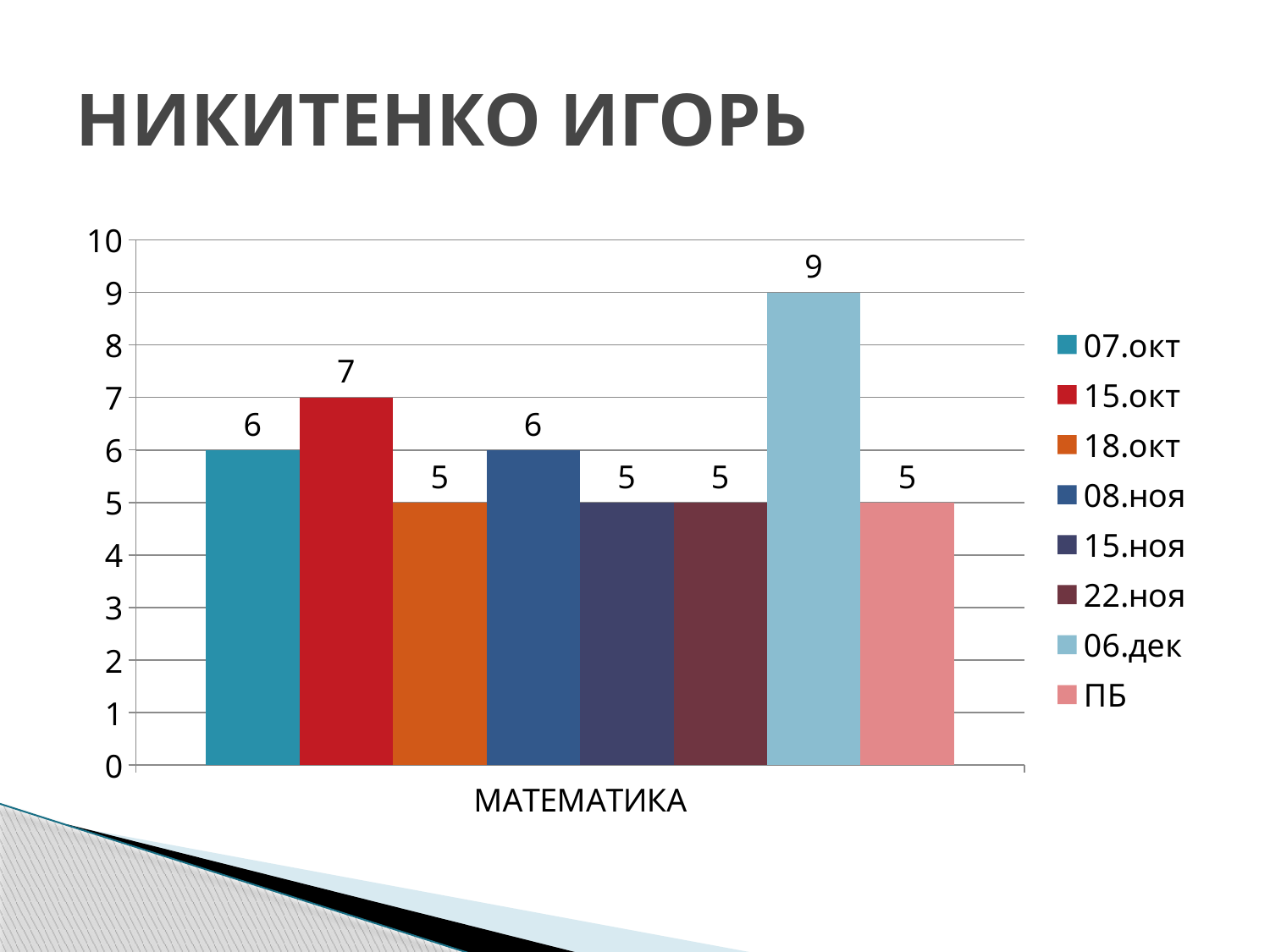
Is the value for 06.дек greater or less than 8? greater How many series have a value of 5? 4 What kind of chart is shown on the slide? bar chart How many series does the legend list? 8 Which series has the highest value? 06.дек What is the value for the ПБ series? 5 What is the value for the 06.дек series? 9 What is the value for the 15.окт series? 7 What is the category label on the x axis? МАТЕМАТИКА What is the value for the 07.окт series in the МАТЕМАТИКА chart? 6 Which is larger, the value for 15.окт or the value for 08.ноя? 15.окт What is the difference between the 06.дек value and the 15.окт value? 2